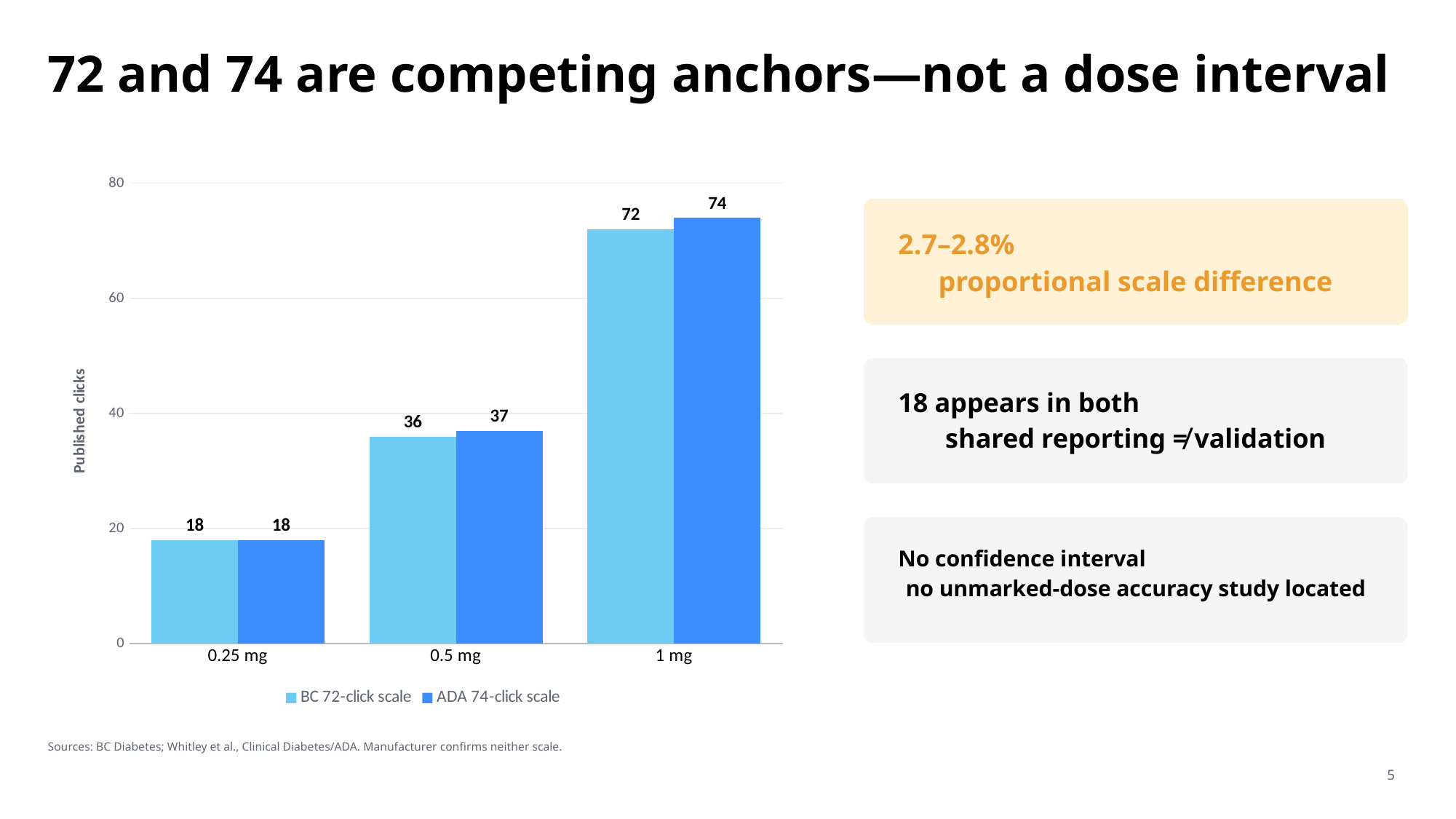
How many dose categories are shown on the x axis? 3 What is the value for the BC 72-click scale at 1 mg? 72 Which dose has the highest value for the ADA 74-click scale? 1 mg Do the BC 72-click scale values rise or fall as the dose increases from 0.25 mg to 1 mg? Rise What is the value for the ADA 74-click scale at 0.5 mg? 37 What is the value for the ADA 74-click scale at 0.25 mg? 18 What is the difference between the ADA 74-click scale and the BC 72-click scale at 1 mg? 2 Which dose has the lowest value for the BC 72-click scale? 0.25 mg Which is larger at 0.5 mg: the BC 72-click scale or the ADA 74-click scale? ADA 74-click scale What is the difference between the BC 72-click scale values at 1 mg and 0.5 mg? 36 What kind of chart is shown on the slide? Bar chart How many series does the legend list? 2